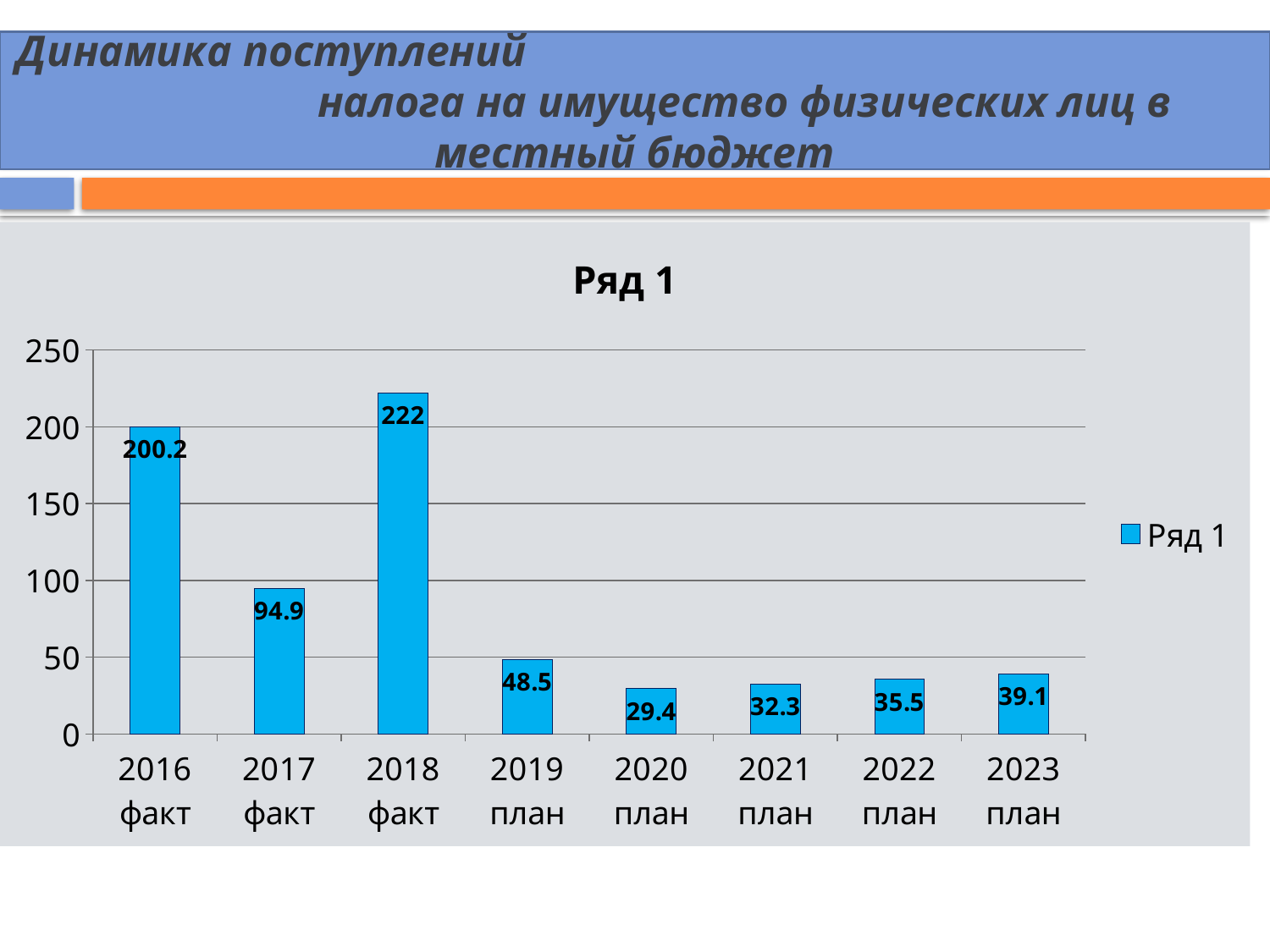
What is the value for 2019 план? 48.5 What is the difference between the values for 2018 факт and 2017 факт? 127.1 Which is larger, the value for 2021 план or the value for 2023 план? 2023 план Do the values rise or fall from 2020 план to 2023 план? rise What is the value for 2016 факт? 200.2 Is the value for 2017 факт greater or less than 100? less How many categories are shown on the x axis? 8 Which category has the lowest value? 2020 план What kind of chart is shown on the slide? bar chart Which category has the highest value? 2018 факт How many series does the legend list? 1 What is the value for 2022 план? 35.5